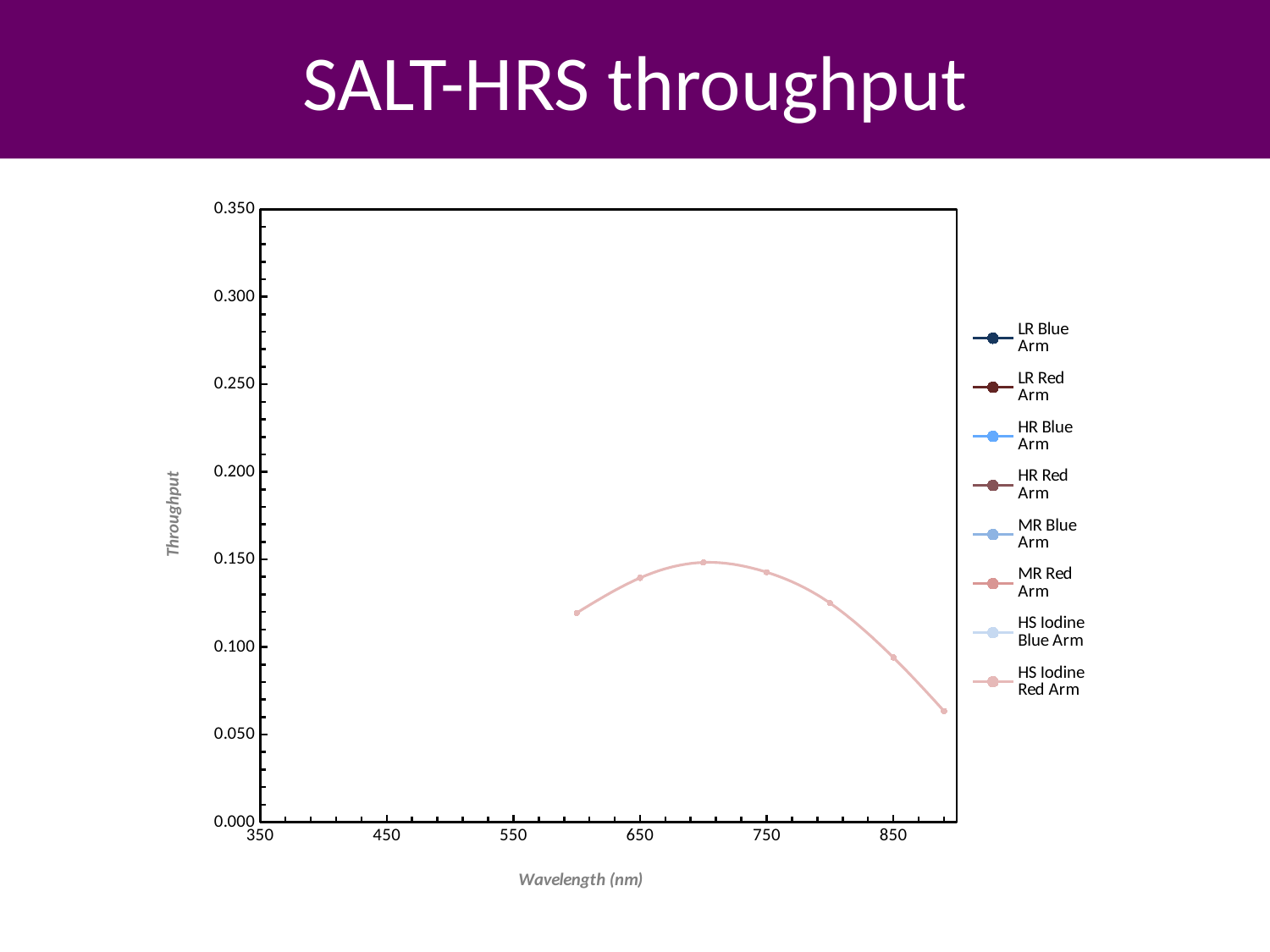
Is the throughput at 850 nm greater or less than 0.100? less What kind of chart is shown on the slide? line chart Is the throughput at 650 nm greater or less than 0.100? greater Which has the higher throughput, the point at 650 nm or the point at 850 nm? 650 nm How many series does the legend list? 8 How many data points are plotted on the visible curve? 7 Does the throughput rise or fall between 750 nm and 850 nm? fall Is the throughput at 800 nm greater or less than 0.150? less What is the title of the chart? SALT-HRS throughput What is the label of the x axis? Wavelength (nm)